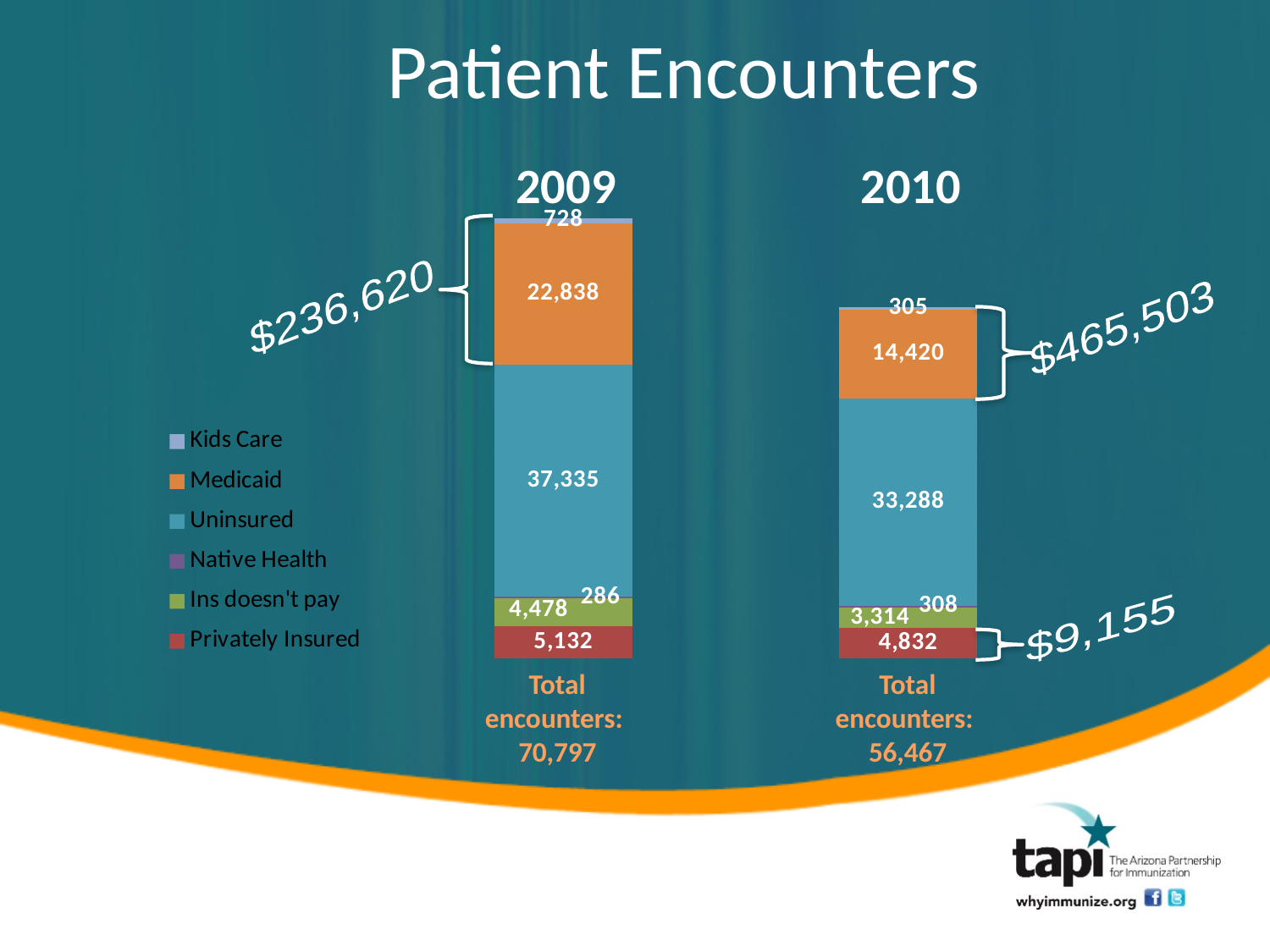
What is the Privately Insured value for 2009? 5,132 What is the difference between the Medicaid values for 2009 and 2010? 8,418 What is the Uninsured value for 2009? 37,335 How many series does the legend list? 6 How many bars (years) are plotted in the chart? 2 What is the Kids Care value for 2010? 305 What is the Medicaid value for 2010? 14,420 Which series is the smallest segment in the 2009 bar? Native Health What kind of chart is shown on the slide? Stacked bar chart Which series is the largest segment in the 2009 bar? Uninsured What is the total number of encounters for the 2010 bar? 56,467 Which year has the larger Ins doesn't pay value, 2009 or 2010? 2009